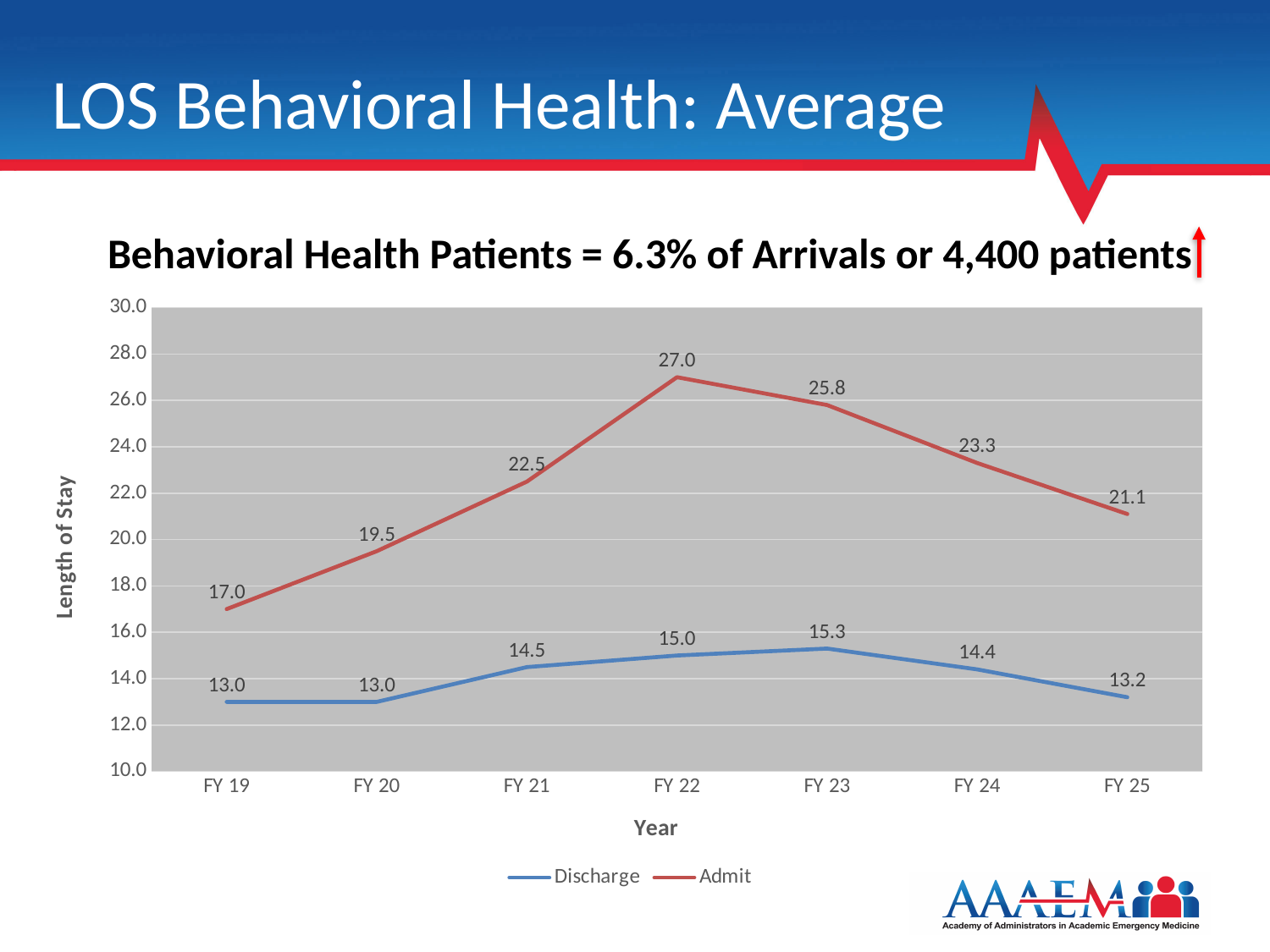
What is the Discharge value for FY 23? 15.3 Which is larger, the Admit value for FY 21 or the Admit value for FY 24? FY 24 What kind of chart is shown on the slide? Line chart What is the Admit value for FY 22? 27.0 Does the Admit line rise or fall from FY 22 to FY 25? Fall What is the difference between the Admit and Discharge values in FY 22? 12.0 In which fiscal year is the Admit length of stay highest? FY 22 What is the label of the y axis? Length of Stay In which fiscal year is the Discharge length of stay lowest? FY 19 and FY 20 How many fiscal years are shown on the x axis? 7 What is the Admit value for FY 19? 17.0 How many series does the legend list? 2